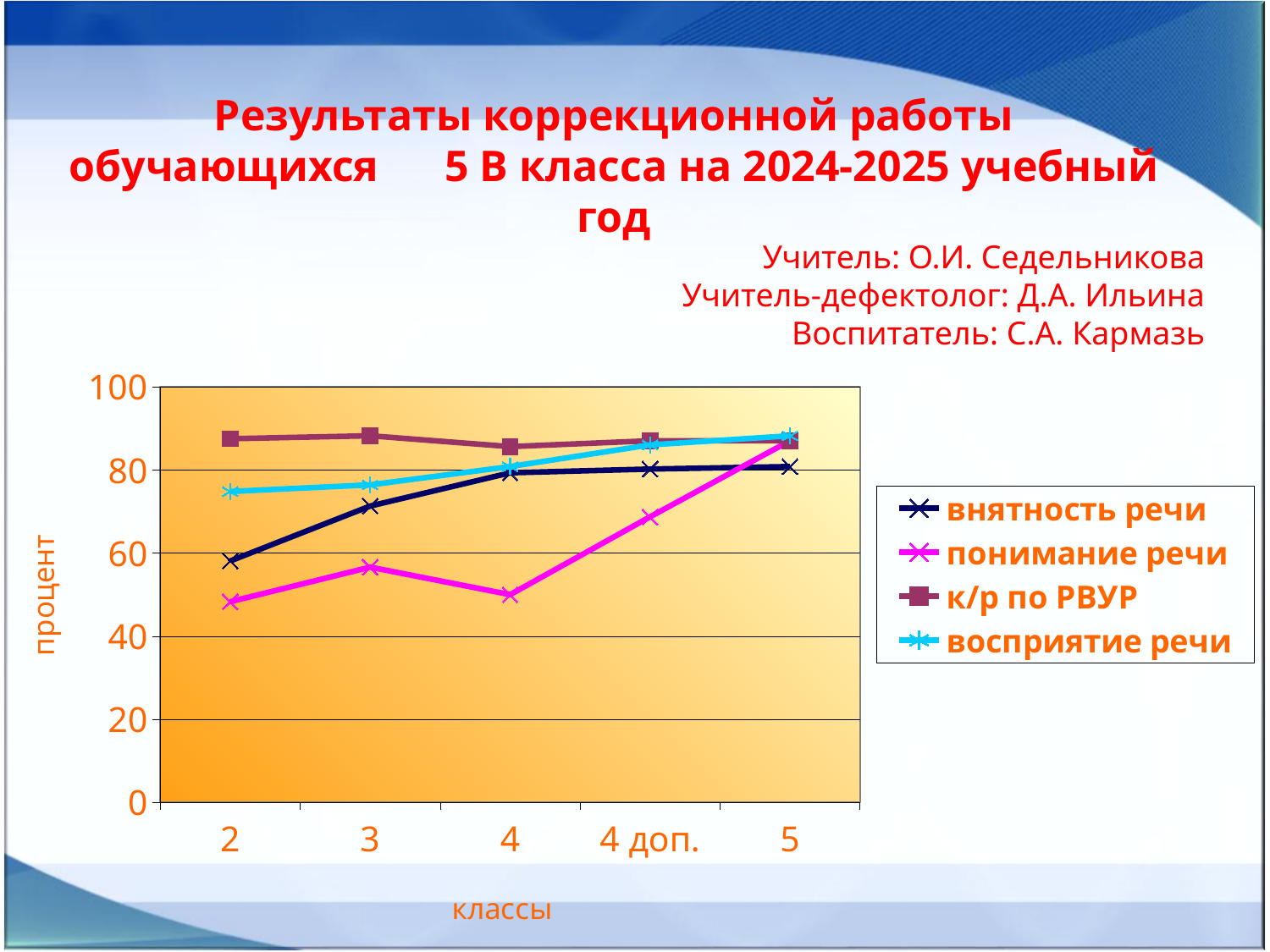
Is the value for восприятие речи in class 4 доп. greater or less than 80? greater Is the value for понимание речи in class 2 greater or less than 60? less Is the value for понимание речи in class 4 greater or less than 60? less How many categories are shown on the x axis? 5 Which series has the lowest value in class 2? понимание речи Which series has the highest value in class 2? к/р по РВУР How many series does the legend list? 4 What is the label of the vertical axis? процент Does the внятность речи line rise or fall from class 2 to class 5? rise What kind of chart is shown on the slide? line chart